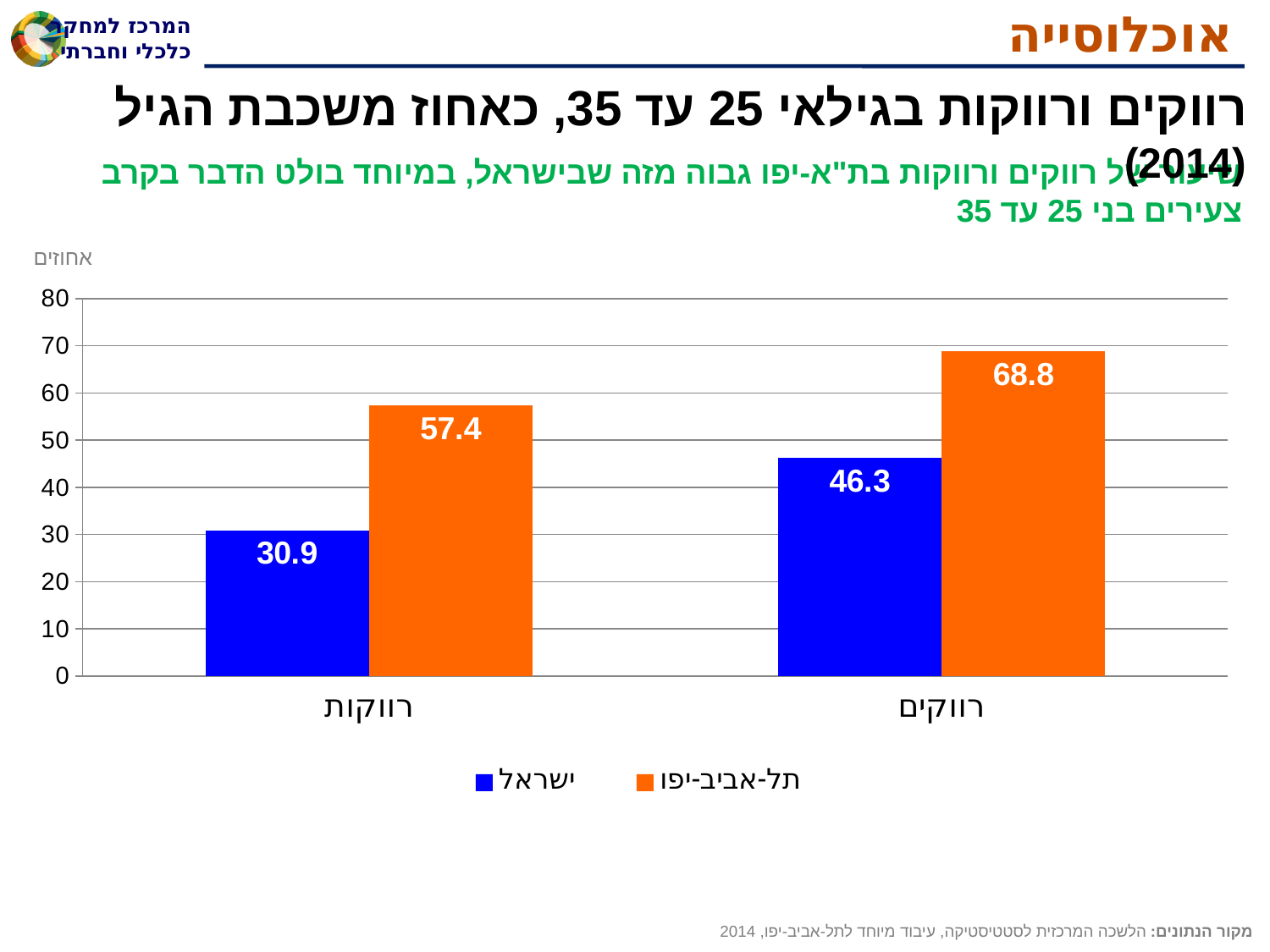
What is the value for תל-אביב-יפו in the רווקות category? 57.4 What kind of chart is shown on the slide? Bar chart How many series does the legend list? 2 What is the value for ישראל in the רווקות category? 30.9 How many categories are shown on the x axis? 2 What is the difference between the תל-אביב-יפו and ישראל values in the רווקות category? 26.5 Which bar has the highest value on the chart? תל-אביב-יפו, רווקים What is the value for ישראל in the רווקים category? 46.3 Which bar has the lowest value on the chart? ישראל, רווקות What is the difference between the תל-אביב-יפו and ישראל values in the רווקים category? 22.5 Which is larger: the ישראל value for רווקים or the תל-אביב-יפו value for רווקות? תל-אביב-יפו value for רווקות What is the value for תל-אביב-יפו in the רווקים category? 68.8